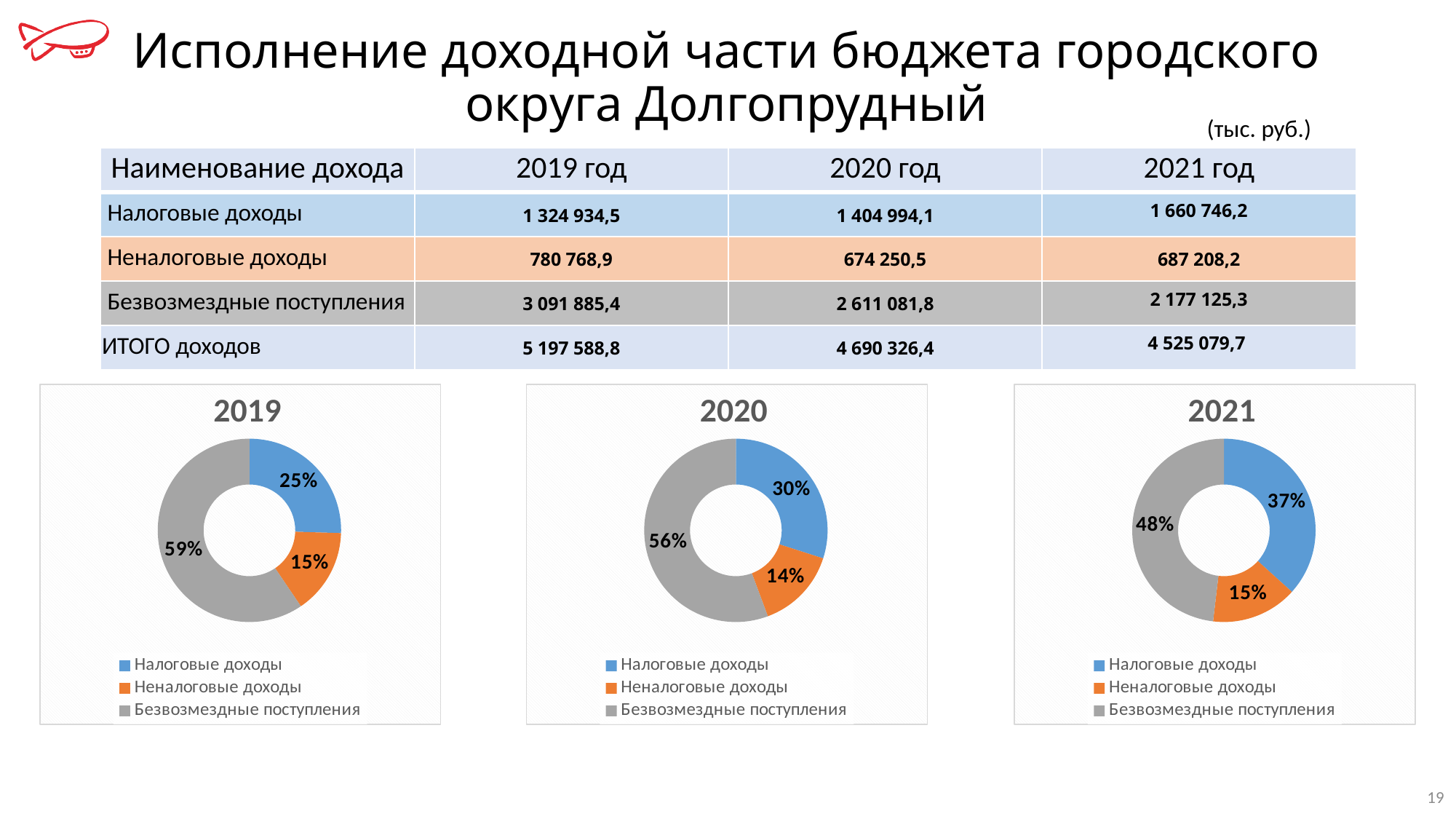
In the chart titled 2019, what share is shown for Налоговые доходы? 25% In the chart titled 2021, which is larger: the share of Налоговые доходы or the share of Неналоговые доходы? Налоговые доходы How many categories does the chart titled 2020 show? 3 What kind of chart is the chart titled 2019? Doughnut (pie) chart In the chart titled 2020, what share is shown for Неналоговые доходы? 14% In the chart titled 2021, what share is shown for Безвозмездные поступления? 48% In the chart titled 2020, which colour represents Неналоговые доходы? Orange In the chart titled 2020, which category has the largest share? Безвозмездные поступления In the chart titled 2021, which category has the smallest share? Неналоговые доходы In the chart titled 2019, what is the difference in percentage points between Безвозмездные поступления and Налоговые доходы? 34 In the chart titled 2019, what share is shown for Безвозмездные поступления? 59% In the chart titled 2021, what share is shown for Налоговые доходы? 37%